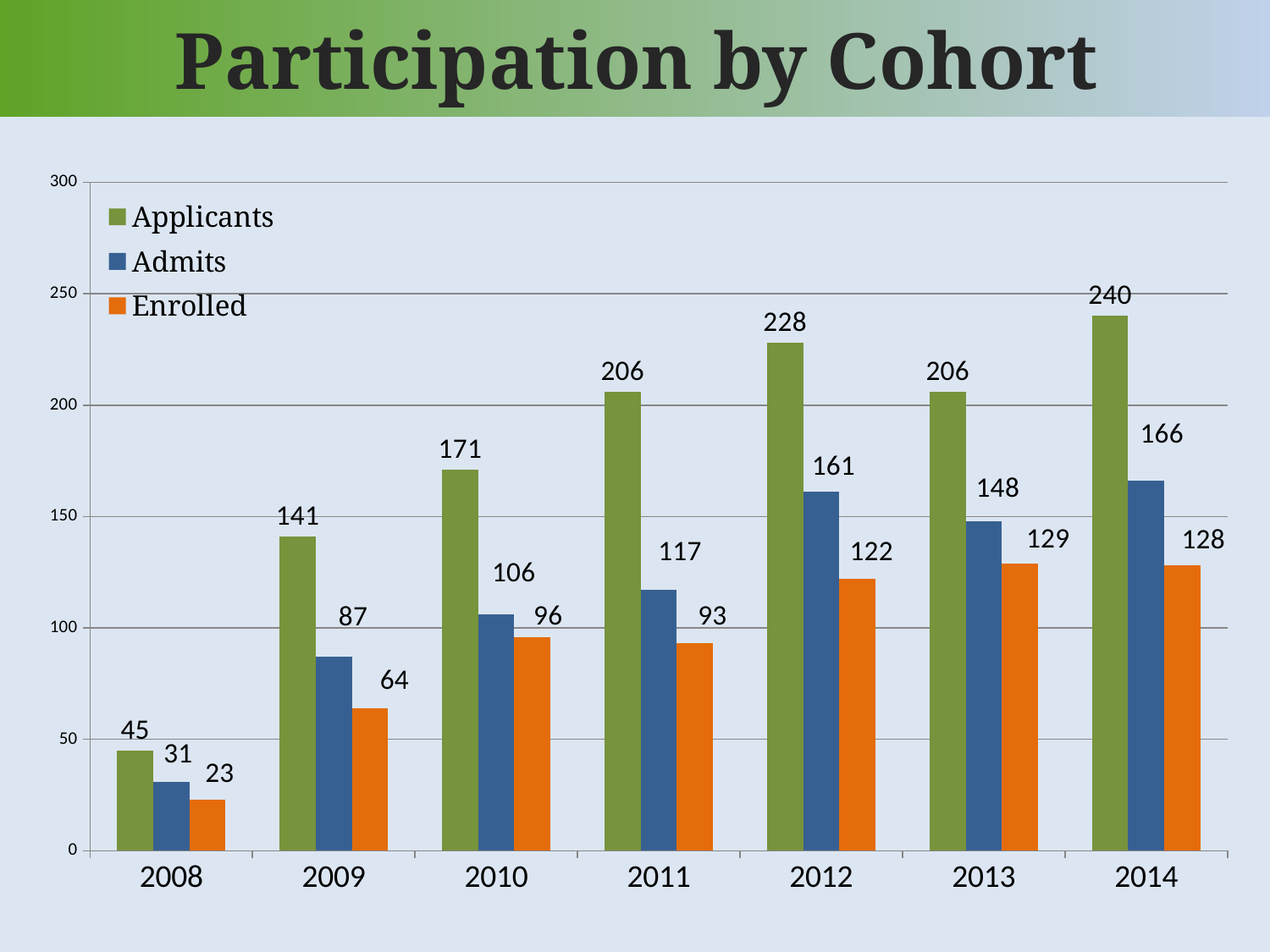
What is the Enrolled value for 2009? 64 What is the title of the slide? Participation by Cohort How many Admits were there in 2013? 148 Which year has the lowest Enrolled value? 2008 How many years are shown on the x axis? 7 What kind of chart is shown on the slide? bar chart Which year has the highest number of Applicants? 2014 What is the difference between Applicants and Admits in 2014? 74 Is the Admits value for 2012 greater or less than 150? greater Which is larger: Enrolled in 2013 or Enrolled in 2014? Enrolled in 2013 How many series does the legend list? 3 How many Applicants were there in 2012? 228